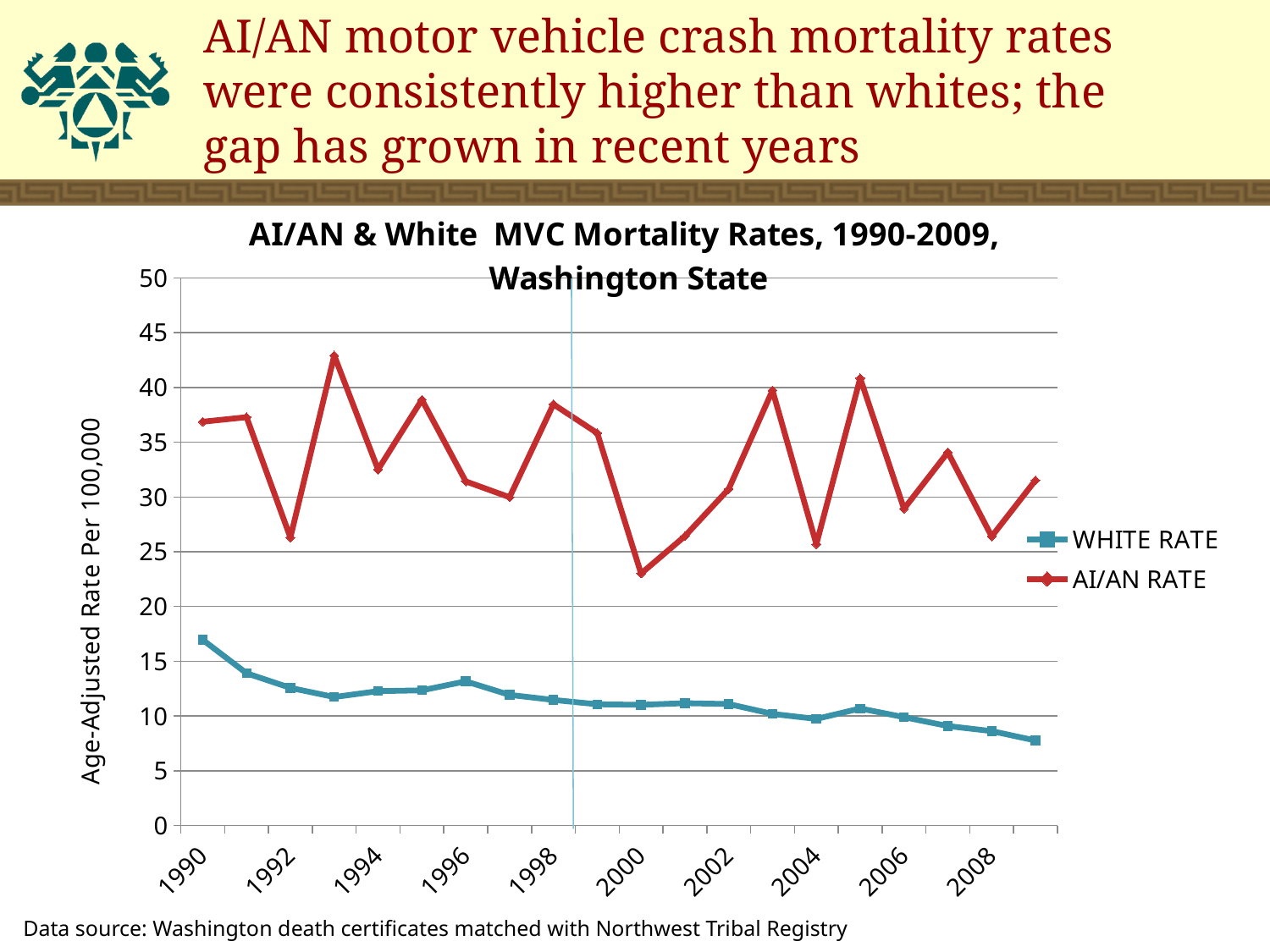
How many series does the legend list? 2 Is the WHITE RATE in 2009 greater or less than 10? less Is the AI/AN RATE in 1993 greater or less than 40? greater In which year does the AI/AN RATE reach its highest value? 1993 In which year is the WHITE RATE lowest? 2009 In which year is the WHITE RATE highest? 1990 What are the two series named in the legend? WHITE RATE and AI/AN RATE Which series has the higher value in 2000, WHITE RATE or AI/AN RATE? AI/AN RATE In which year does the AI/AN RATE reach its lowest value? 2000 What kind of chart is shown on the slide? Line chart Is the AI/AN RATE in 2004 greater or less than 30? less What is the label of the vertical axis? Age-Adjusted Rate Per 100,000